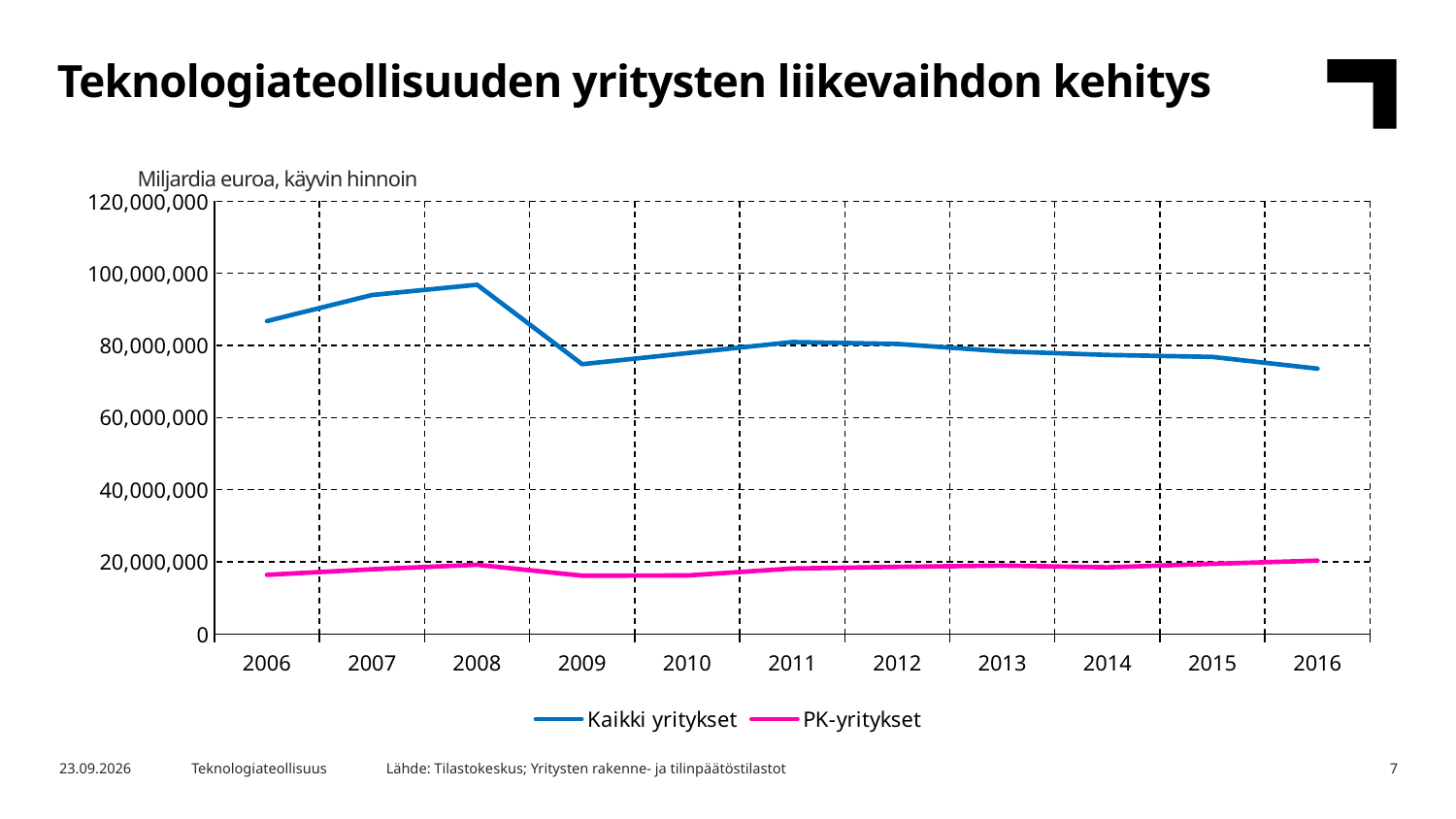
Is the value for Kaikki yritykset in 2009 greater or less than 80,000,000? less Does the Kaikki yritykset series rise or fall from 2011 to 2016? Fall How many series does the legend list? 2 Is the value for Kaikki yritykset in 2016 greater or less than 80,000,000? less Is the value for Kaikki yritykset in 2008 greater or less than 80,000,000? greater How many years are shown on the x axis? 11 What kind of chart is shown on the slide? Line chart Does the Kaikki yritykset series rise or fall from 2006 to 2008? Rise Which series has the larger value in 2010, Kaikki yritykset or PK-yritykset? Kaikki yritykset In which year does the Kaikki yritykset series reach its highest value? 2008 What is the title of the chart? Teknologiateollisuuden yritysten liikevaihdon kehitys